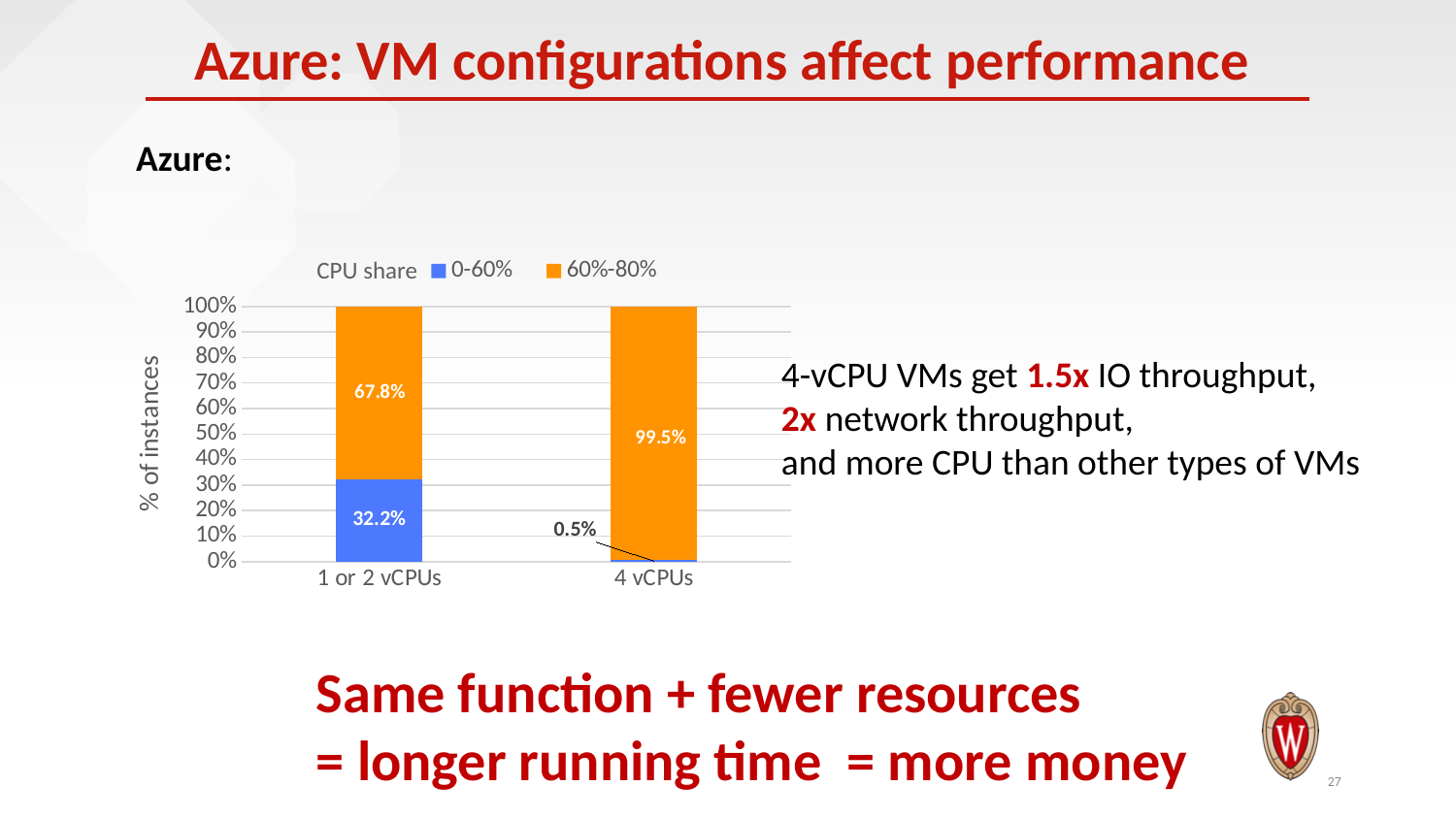
What is the value of the 60%-80% series for 1 or 2 vCPUs? 67.8% What is the difference between the 60%-80% values for 4 vCPUs and 1 or 2 vCPUs? 31.7% What is the label of the y axis? % of instances How many categories are shown on the x axis? 2 Which category has the lower value for the 60%-80% series? 1 or 2 vCPUs What is the value of the 0-60% series for 1 or 2 vCPUs? 32.2% How many series does the legend list? 2 Is the 60%-80% value for 1 or 2 vCPUs larger or smaller than the 0-60% value for 1 or 2 vCPUs? larger Which category has the higher value for the 0-60% series? 1 or 2 vCPUs What is the value of the 0-60% series for 4 vCPUs? 0.5% What is the value of the 60%-80% series for 4 vCPUs? 99.5% What kind of chart is shown on the slide? stacked bar chart